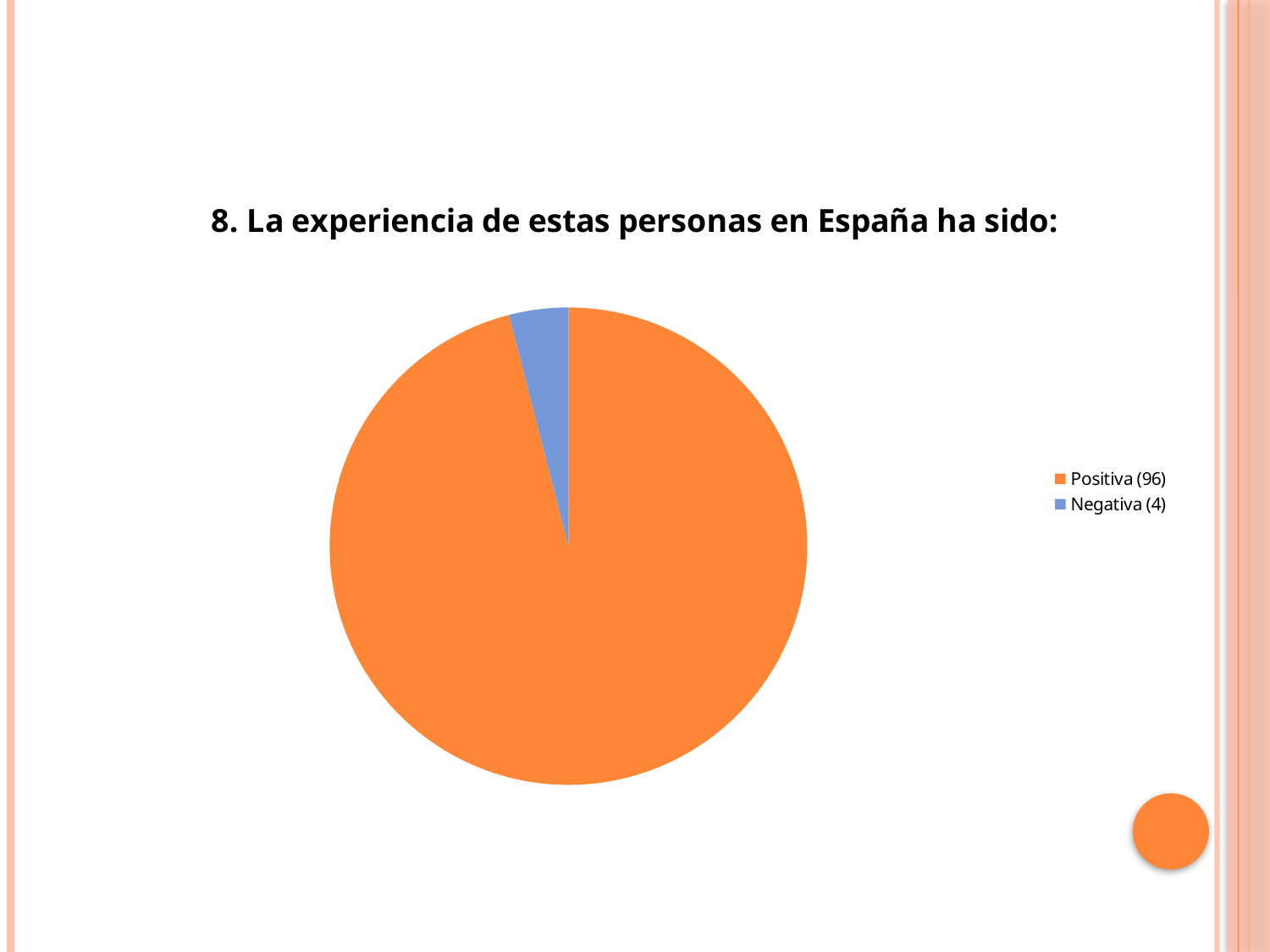
What colour is the Negativa slice? blue Which category has the largest slice of the pie? Positiva What value is shown for Positiva in the legend? 96 Which category has the smallest slice of the pie? Negativa Which is larger, the value for Positiva or the value for Negativa? Positiva How many slices does the pie chart have? 2 What kind of chart is shown on the slide? pie chart What value is shown for Negativa in the legend? 4 What is the title of the chart? 8. La experiencia de estas personas en España ha sido: What is the difference between the values for Positiva and Negativa? 92 How many entries does the legend list? 2 What share of the pie does the Positiva slice represent? 96%